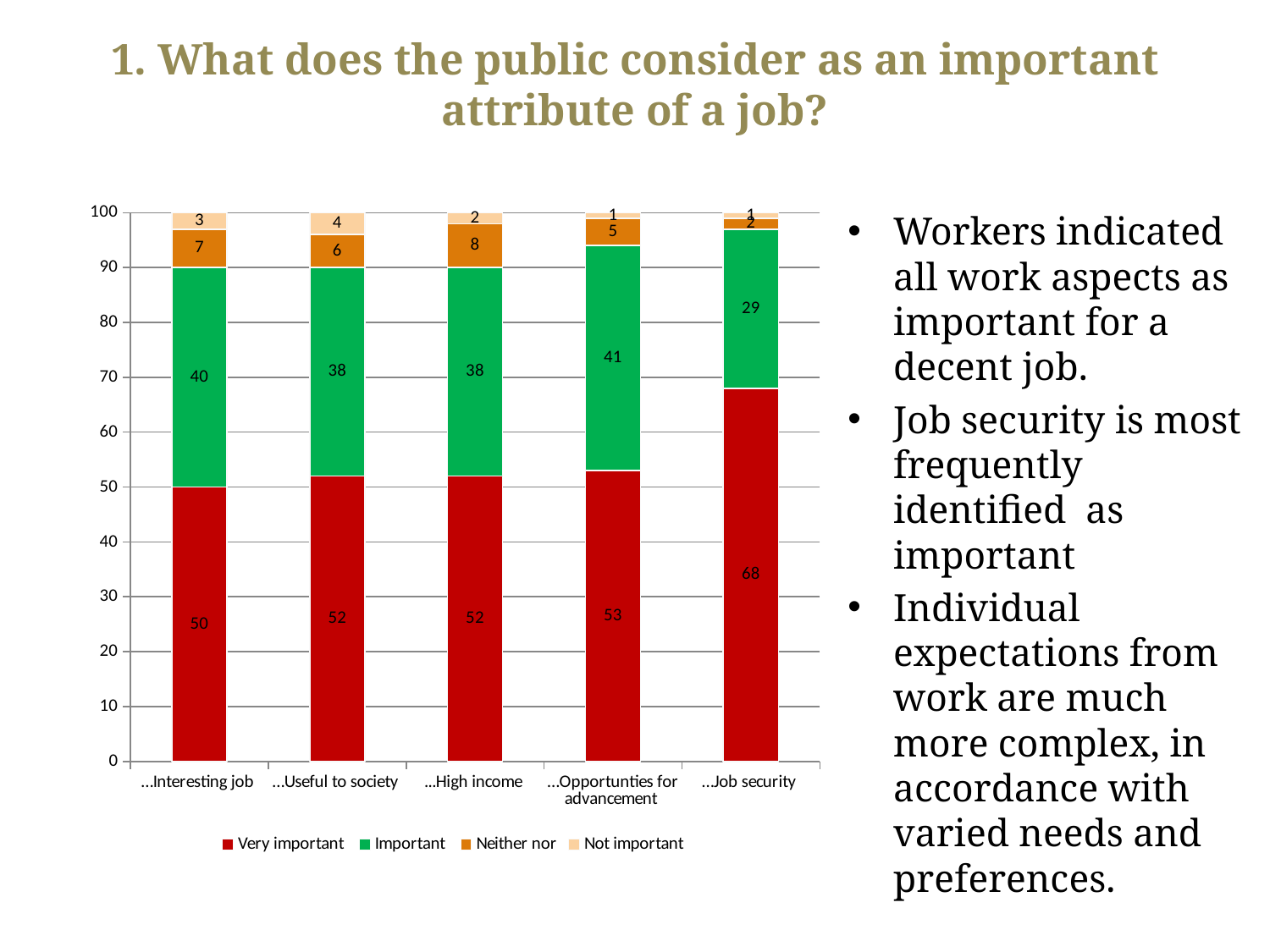
What is the total of the stacked bar for High income? 100 What kind of chart is shown on the slide? Stacked bar chart How many job attributes (categories) are shown on the x axis? 5 How many series does the legend list? 4 What is the 'Neither nor' value for High income? 8 Which category has the lowest 'Important' value? Job security What is the 'Very important' value for Job security? 68 Which category has the highest 'Very important' value? Job security What is the 'Important' value for Opportunities for advancement? 41 What is the difference between the 'Very important' values for Job security and Interesting job? 18 Which is larger: the 'Neither nor' value for Interesting job or for Useful to society? Interesting job What is the 'Not important' value for Useful to society? 4